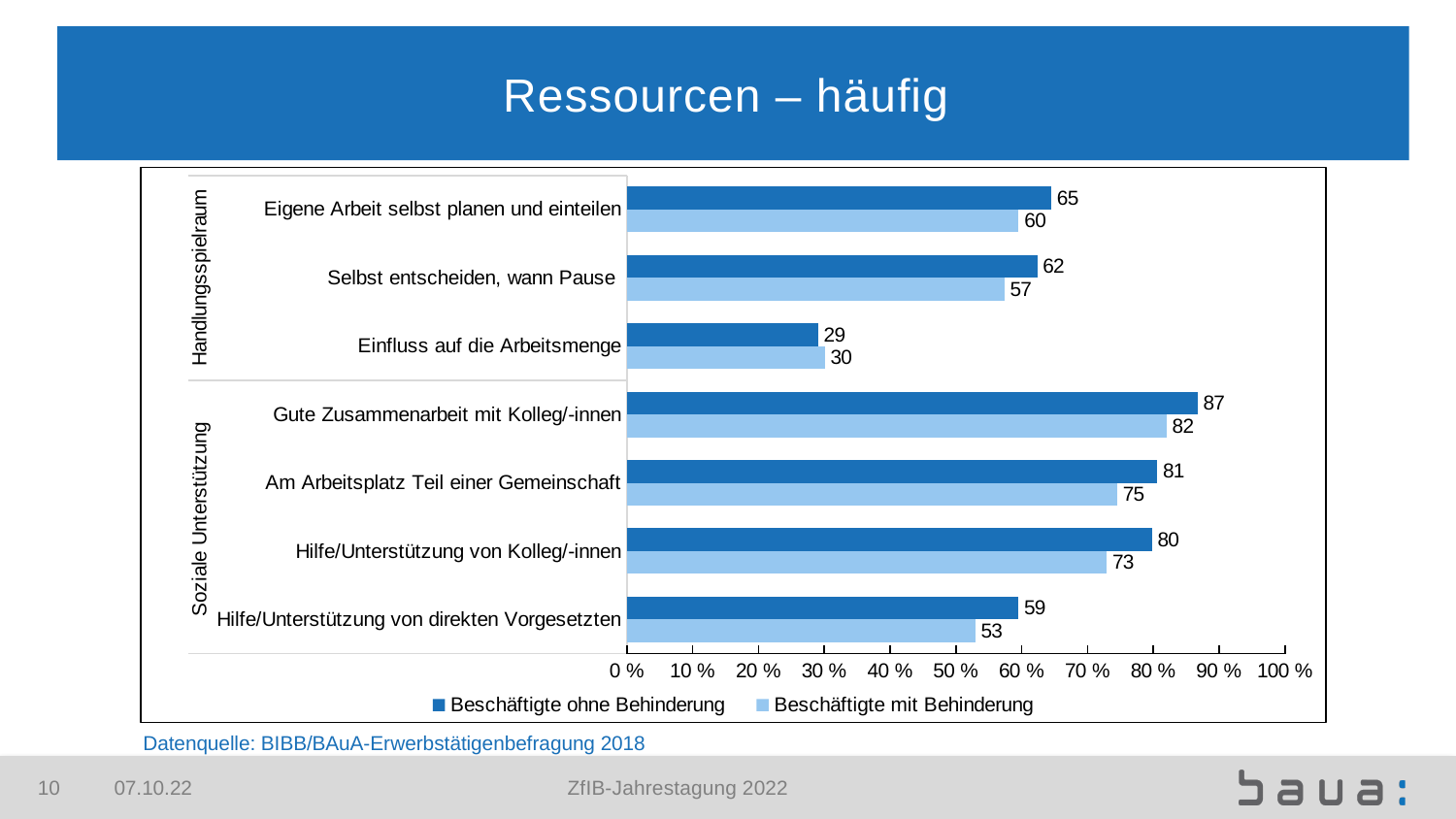
What is the value for "Beschäftigte ohne Behinderung" for "Eigene Arbeit selbst planen und einteilen"? 65 Is the value for "Beschäftigte mit Behinderung" for "Hilfe/Unterstützung von Kolleg/-innen" greater or less than 70 %? greater What is the value for "Beschäftigte mit Behinderung" for "Hilfe/Unterstützung von direkten Vorgesetzten"? 53 What is the difference between "Beschäftigte ohne Behinderung" and "Beschäftigte mit Behinderung" for "Am Arbeitsplatz Teil einer Gemeinschaft"? 6 For "Einfluss auf die Arbeitsmenge", which series has the larger value? Beschäftigte mit Behinderung Which category has the lowest value for "Beschäftigte mit Behinderung"? Einfluss auf die Arbeitsmenge What is the value for "Beschäftigte ohne Behinderung" for "Selbst entscheiden, wann Pause"? 62 Which category has the highest value for "Beschäftigte ohne Behinderung"? Gute Zusammenarbeit mit Kolleg/-innen How many series does the legend list? 2 How many categories are shown on the chart? 7 What is the title of the slide? Ressourcen – häufig What kind of chart is shown on the slide? bar chart